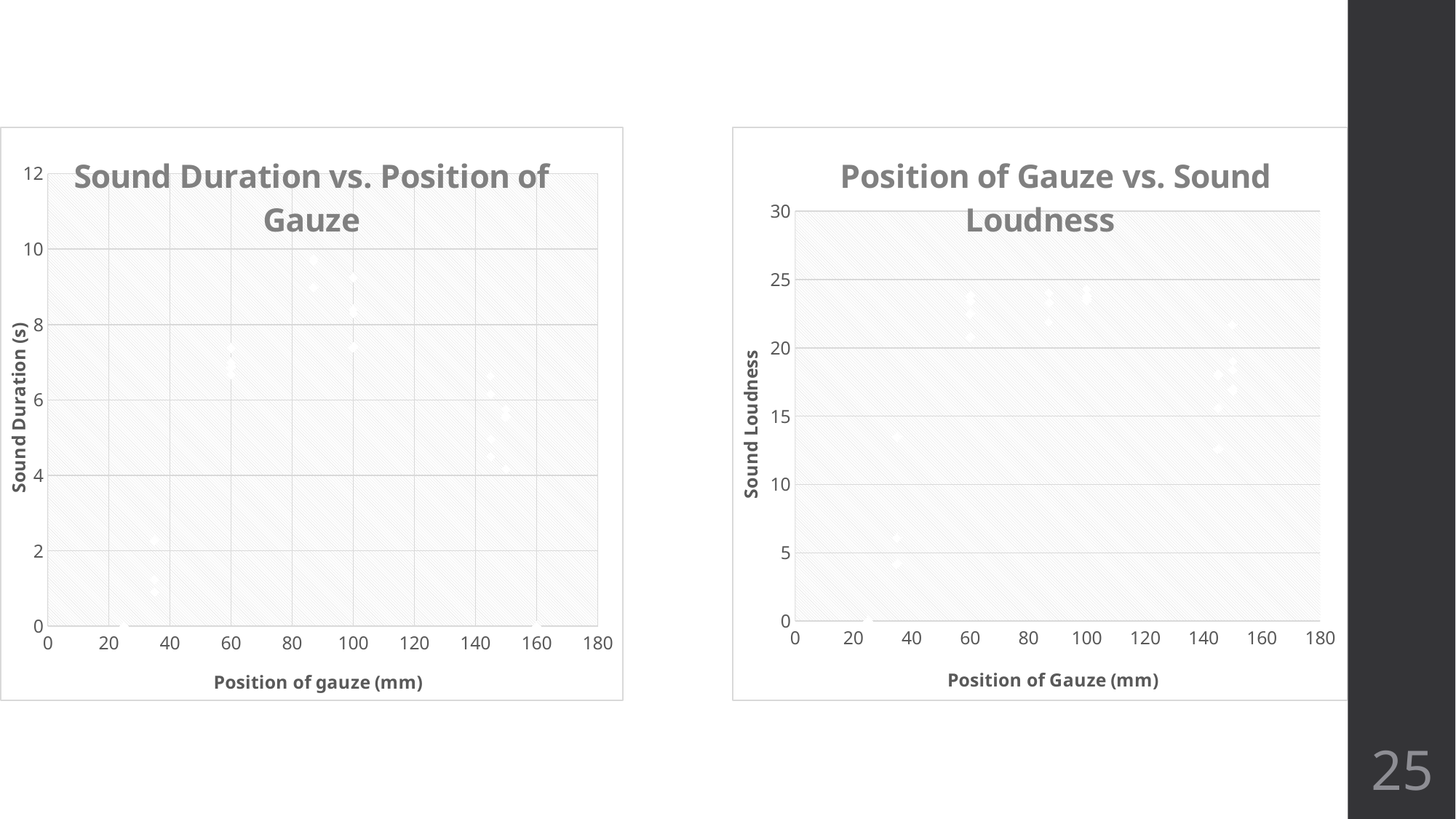
In the left chart 'Sound Duration vs. Position of Gauze', are the sound duration values for the points at a gauze position of about 35 mm greater or less than 4? less What kind of chart is the left chart titled 'Sound Duration vs. Position of Gauze'? scatter chart In the left chart 'Sound Duration vs. Position of Gauze', what is the label of the y axis? Sound Duration (s) In the right chart 'Position of Gauze vs. Sound Loudness', which group of points has higher loudness: those at about 100 mm or those at about 35 mm? those at about 100 mm In the right chart 'Position of Gauze vs. Sound Loudness', are the loudness values for the points at a gauze position of about 35 mm greater or less than 15? less In the right chart 'Position of Gauze vs. Sound Loudness', what is the label of the x axis? Position of Gauze (mm) What kind of chart is the right chart titled 'Position of Gauze vs. Sound Loudness'? scatter chart In the left chart 'Sound Duration vs. Position of Gauze', are the sound duration values for the points at a gauze position of about 87 mm greater or less than 8? greater In the left chart 'Sound Duration vs. Position of Gauze', which group of points has higher sound duration: those at about 87 mm or those at about 35 mm? those at about 87 mm